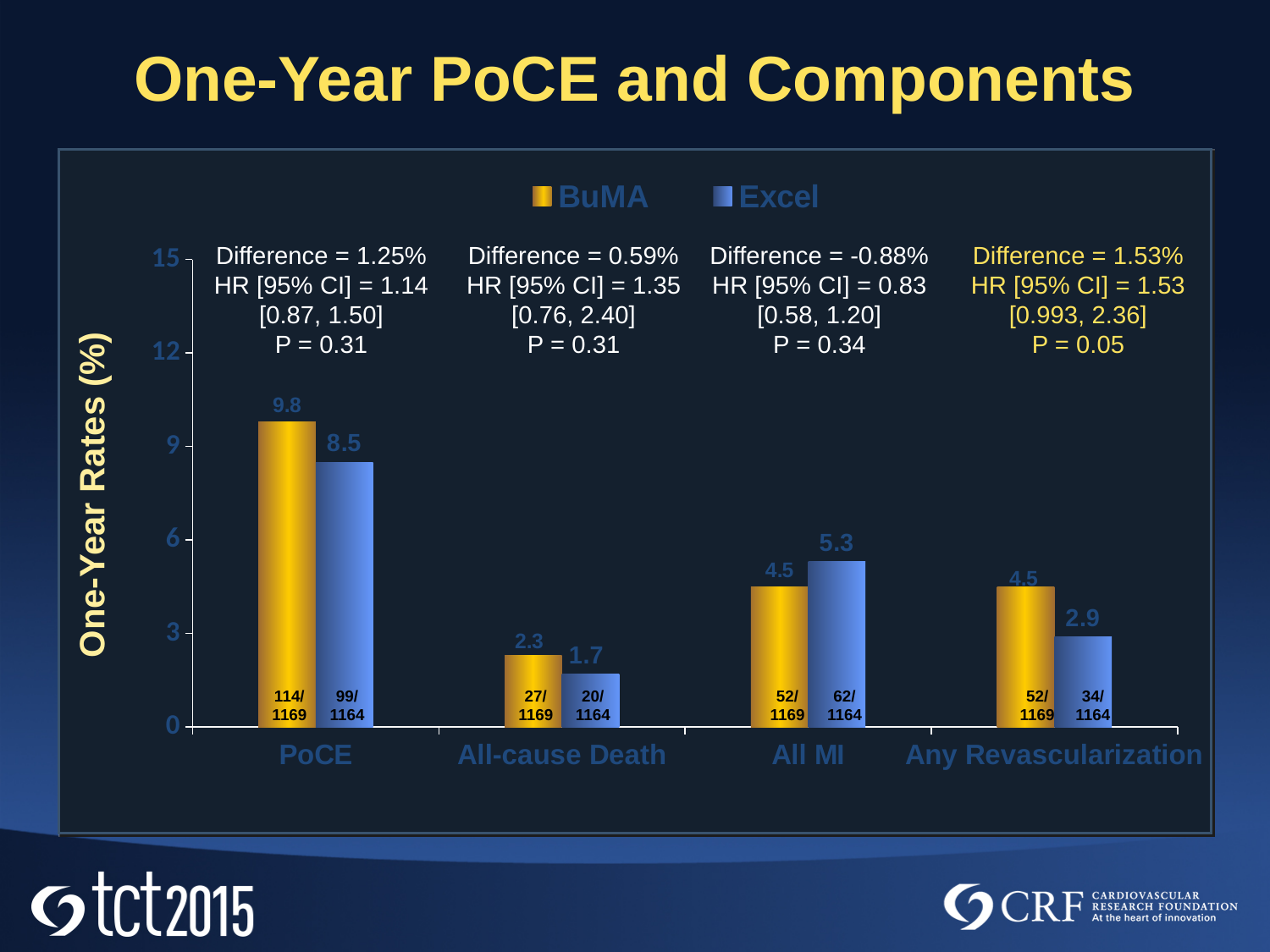
What is the one-year rate for BuMA in the PoCE category? 9.8 How many categories are shown on the x axis? 4 What is the one-year rate for Excel in the All MI category? 5.3 What is the label of the y axis? One-Year Rates (%) In the All MI category, which series has the larger one-year rate, BuMA or Excel? Excel How many series does the legend list? 2 What is the one-year rate for Excel in the Any Revascularization category? 2.9 Is the BuMA value for All-cause Death greater or less than 3? less What is the difference between the BuMA and Excel rates in the PoCE category? 1.3 What kind of chart is shown on the slide? bar chart Which category has the highest BuMA one-year rate? PoCE Which category has the lowest Excel one-year rate? All-cause Death